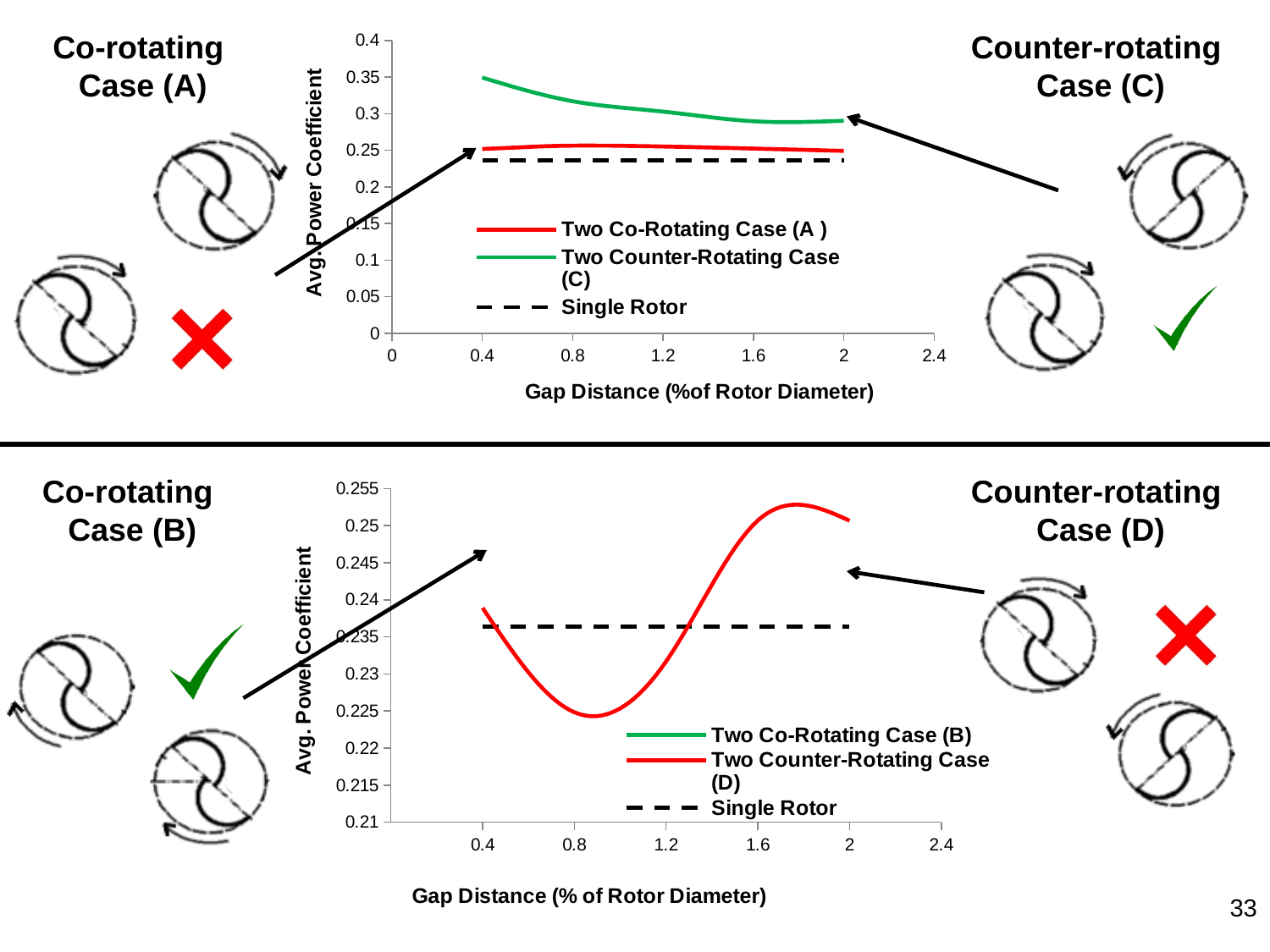
In the top chart, does the Two Counter-Rotating Case (C) line rise or fall as gap distance increases from 0.4 to 2? fall In the top chart, is the value of Two Counter-Rotating Case (C) at a gap distance of 0.4 greater or less than 0.3? greater In the bottom chart, is the value of Two Counter-Rotating Case (D) at a gap distance of 2 greater or less than 0.245? greater In the top chart, which series has the higher value at a gap distance of 0.4: Two Co-Rotating Case (A) or Two Counter-Rotating Case (C)? Two Counter-Rotating Case (C) In the bottom chart, is the value of Two Counter-Rotating Case (D) at a gap distance of 0.8 greater or less than 0.23? less What kind of chart is the bottom chart on the slide? line chart What kind of chart is the top chart on the slide? line chart How many series does the legend of the top chart list? 3 What is the y-axis title of the top chart? Avg. Power Coefficient In the top chart, which series is drawn as a dashed black line? Single Rotor How many series does the legend of the bottom chart list? 3